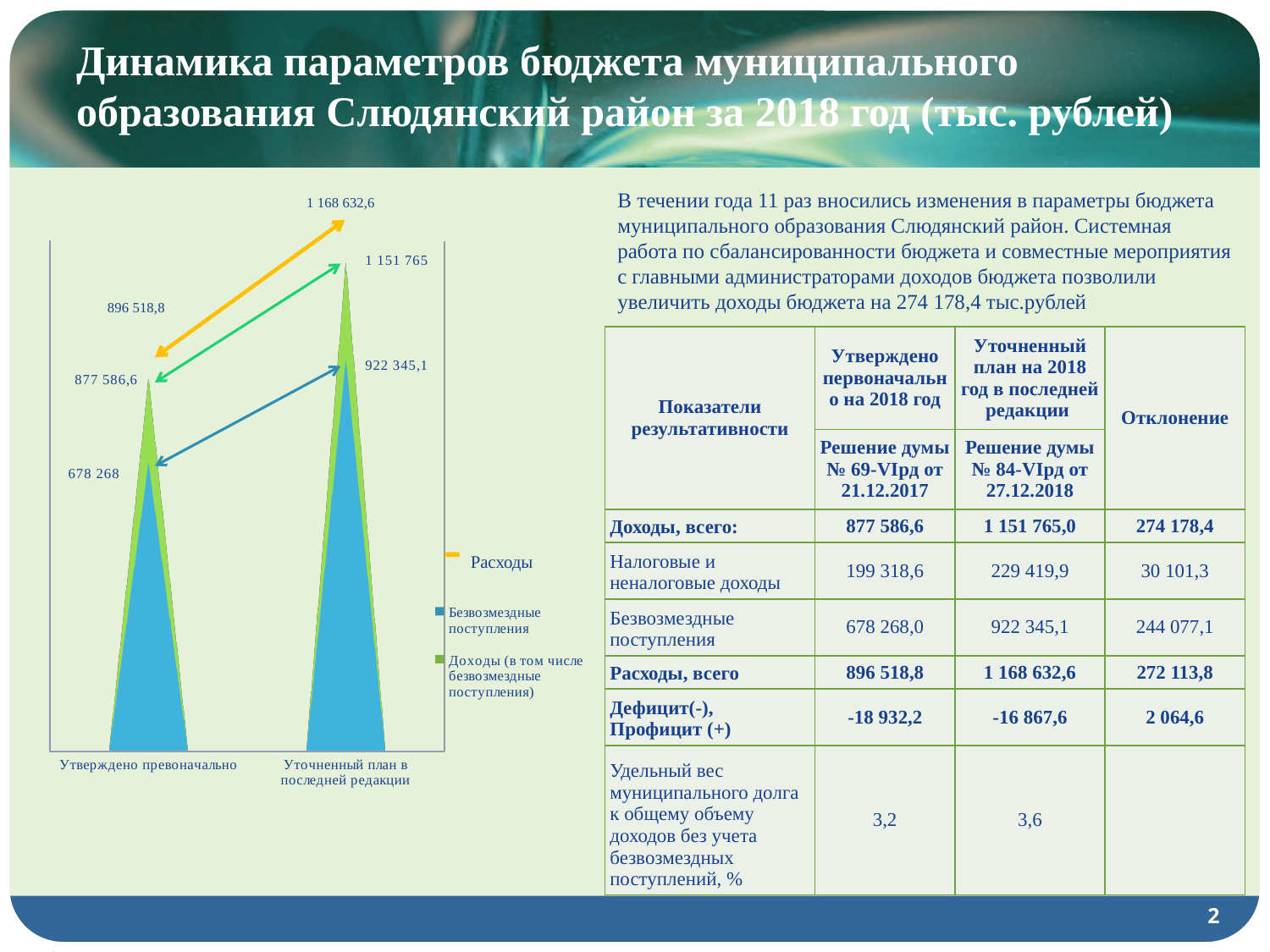
What is the value of Доходы (в том числе безвозмездные поступления) for Утверждено превоначально? 877 586,6 What is the difference between Доходы (в том числе безвозмездные поступления) in Уточненный план в последней редакции and in Утверждено превоначально? 274 178,4 Which is larger for Утверждено превоначально: Расходы or Доходы (в том числе безвозмездные поступления)? Расходы By how much did Расходы increase from Утверждено превоначально to Уточненный план в последней редакции? 272 113,8 How many series does the chart legend list? 3 Do the values of Расходы rise or fall from Утверждено превоначально to Уточненный план в последней редакции? rise What is the value of Расходы for Утверждено превоначально? 896 518,8 What is the value of Безвозмездные поступления for Утверждено превоначально? 678 268 Which series has the lowest value in the chart? Безвозмездные поступления How many categories are shown on the x axis of the chart? 2 What is the value of Безвозмездные поступления for Уточненный план в последней редакции? 922 345,1 What is the value of Расходы for Уточненный план в последней редакции? 1 168 632,6